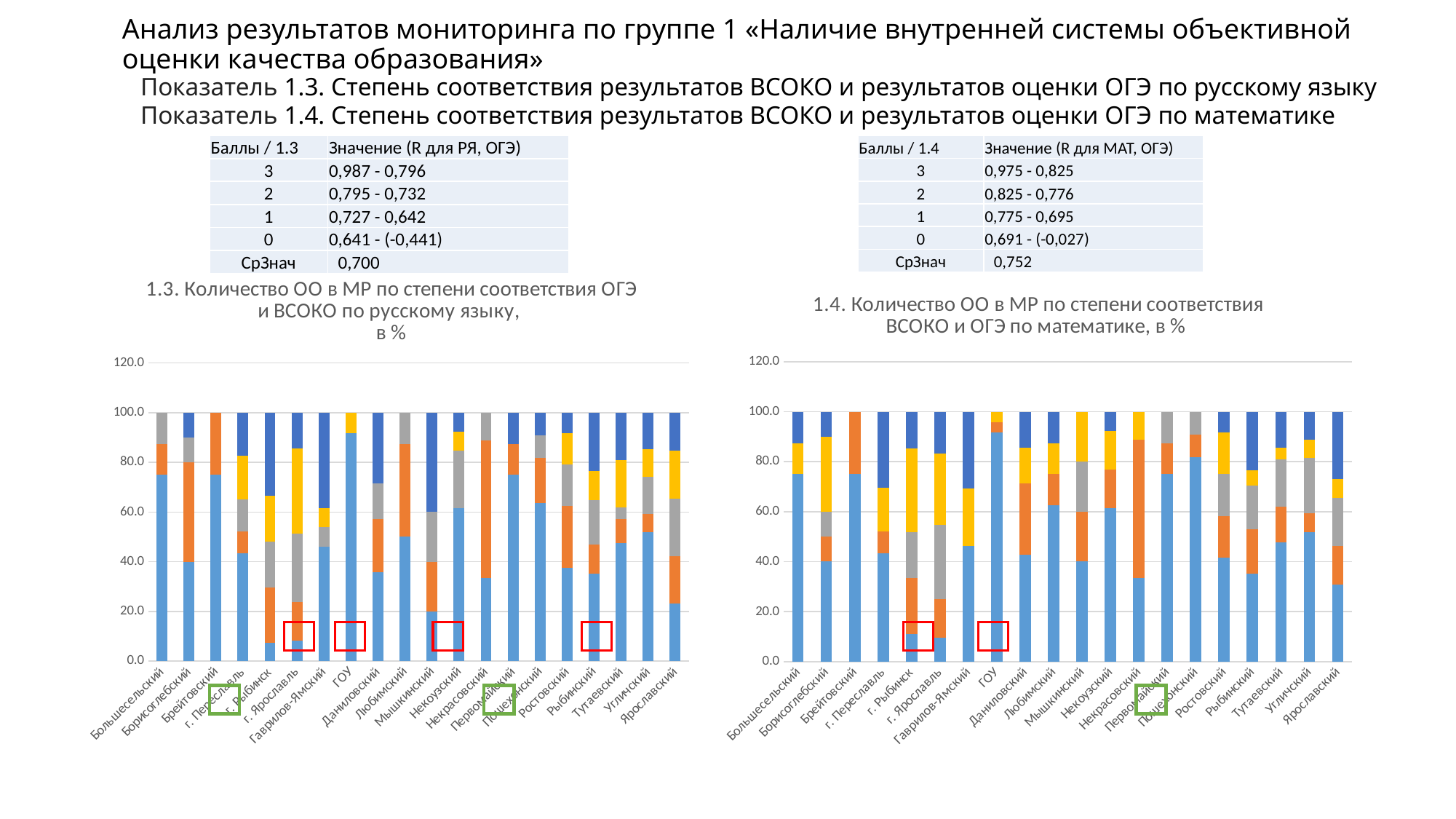
In the left chart (1.3, русский язык), which has the larger blue segment: Большесельский or Борисоглебский? Большесельский In the left chart (1.3, русский язык), is the blue segment for ГОУ greater or less than 80? greater In the right chart (1.4, математика), what is the total height of the stacked bar for Большесельский? 100.0 What is the highest value shown on the y axis of the left chart (1.3, русский язык)? 120.0 What kind of chart is the left chart titled "1.3. Количество ОО в МР по степени соответствия ОГЭ и ВСОКО по русскому языку, в %"? stacked bar chart In the left chart (1.3, русский язык), which category has the tallest blue segment? ГОУ In the left chart (1.3, русский язык), is the blue segment for Большесельский greater or less than 60? greater In the right chart (1.4, математика), which category has the tallest blue segment? ГОУ In the right chart (1.4, математика), is the blue segment for г. Рыбинск greater or less than 20? less How many categories (districts) are shown on the x axis of the right chart "1.4. Количество ОО в МР по степени соответствия ВСОКО и ОГЭ по математике, в %"? 20